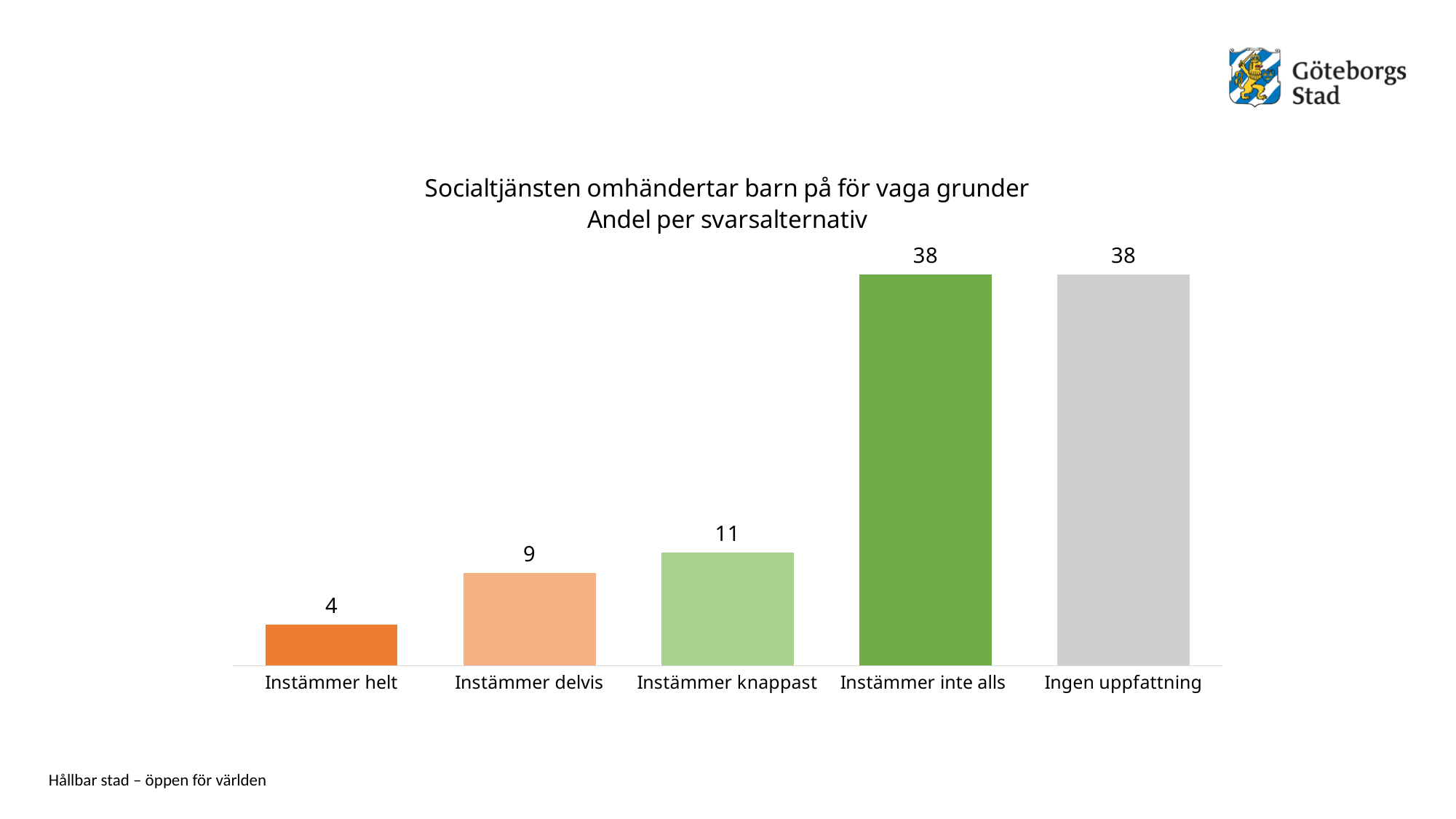
What is the value for Instämmer knappast? 11 What is the value for Ingen uppfattning? 38 What is the difference between the values for Instämmer knappast and Instämmer delvis? 2 Which category has the lowest value? Instämmer helt What is the value for Instämmer delvis? 9 What is the value for Instämmer inte alls? 38 What kind of chart is shown on the slide? Bar chart Which is larger, the value for Instämmer delvis or the value for Instämmer knappast? Instämmer knappast What is the value for Instämmer helt? 4 What is the first line of the chart title? Socialtjänsten omhändertar barn på för vaga grunder How many categories are shown on the x axis? 5 What is the difference between the values for Instämmer inte alls and Instämmer helt? 34